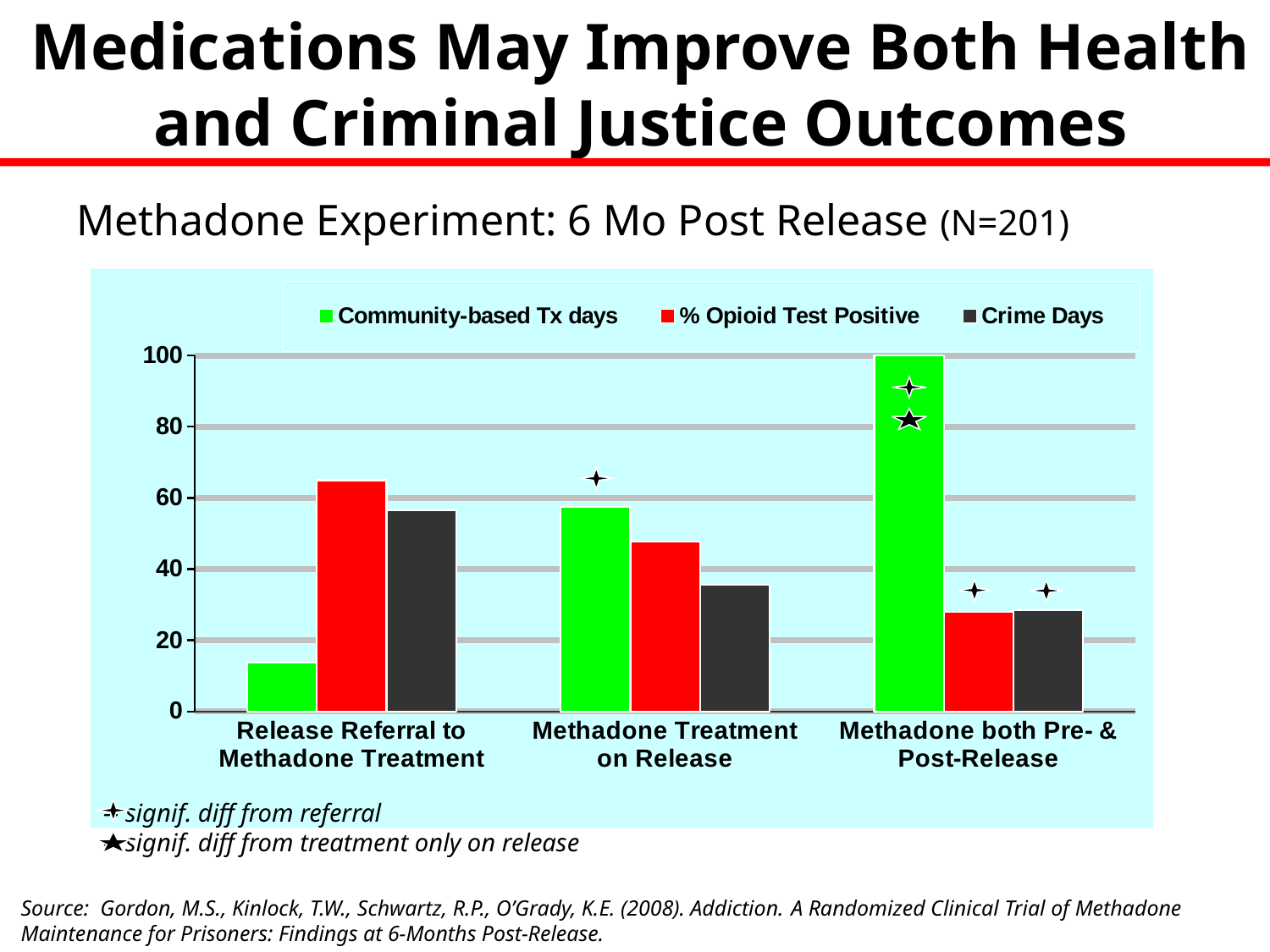
Do the values for Community-based Tx days rise or fall moving left to right across the categories? rise Which category has the highest value for Crime Days? Release Referral to Methadone Treatment Which category has the highest value for Community-based Tx days? Methadone both Pre- & Post-Release How many categories are shown on the x axis? 3 Which is larger in the Methadone Treatment on Release group: Community-based Tx days or Crime Days? Community-based Tx days Is the value for % Opioid Test Positive in the Release Referral to Methadone Treatment group greater or less than 60? greater How many series does the legend list? 3 Is the value for Crime Days in the Methadone both Pre- & Post-Release group greater or less than 40? less Which category has the highest value for % Opioid Test Positive? Release Referral to Methadone Treatment Which category has the lowest value for Community-based Tx days? Release Referral to Methadone Treatment What kind of chart is shown on the slide? bar chart Is the value for Community-based Tx days in the Release Referral to Methadone Treatment group greater or less than 20? less